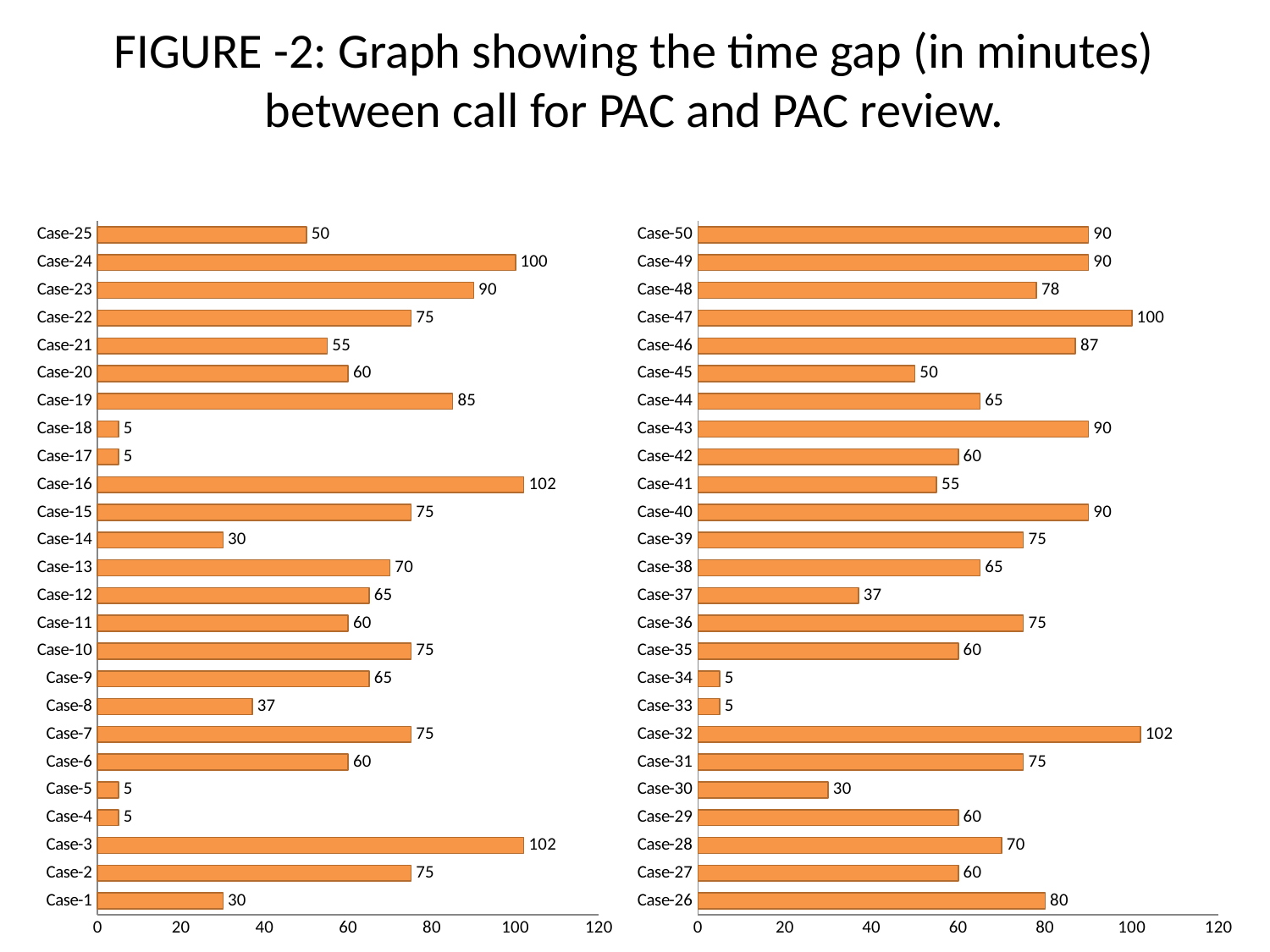
In the left chart (Case-1 to Case-25), what is the value for Case-19? 85 In the right chart (Case-26 to Case-50), which is larger, the value for Case-37 or the value for Case-26? Case-26 In the left chart (Case-1 to Case-25), which is larger, the value for Case-13 or the value for Case-14? Case-13 How many cases are plotted in the left chart (Case-1 to Case-25)? 25 In the right chart (Case-26 to Case-50), what is the value for Case-48? 78 In the left chart (Case-1 to Case-25), what is the value for Case-8? 37 In the left chart (Case-1 to Case-25), what is the difference between the values for Case-24 and Case-25? 50 What is the title of the figure on the slide? FIGURE -2: Graph showing the time gap (in minutes) between call for PAC and PAC review. In the right chart (Case-26 to Case-50), what is the value for Case-46? 87 In the right chart (Case-26 to Case-50), which case has the highest value? Case-32 What type of chart is used on this slide? Bar chart In the right chart (Case-26 to Case-50), what is the difference between the values for Case-47 and Case-45? 50